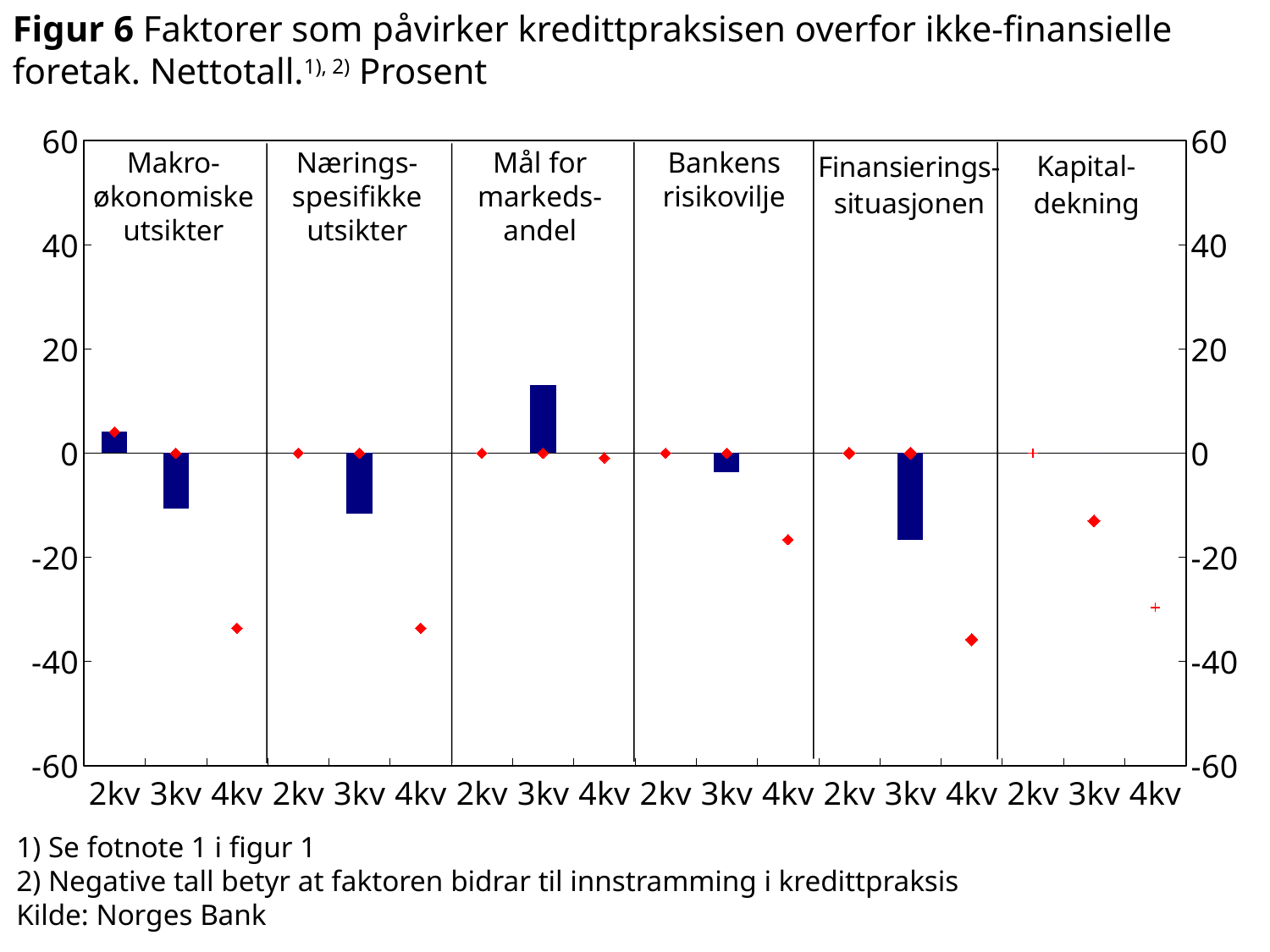
Is the 4kv value for Makroøkonomiske utsikter greater or less than -20? less Is the 3kv bar for Finansieringssituasjonen greater or less than -20? greater How many factor panels are shown in the chart? 6 Which factor has the lowest bar for 3kv? Finansieringssituasjonen What kind of chart is shown in Figur 6? combination bar and line chart (bars with diamond point markers) Do the values for Makroøkonomiske utsikter rise or fall from 2kv to 4kv? fall What is the source of the chart? Norges Bank Which is larger, the 3kv bar for Makroøkonomiske utsikter or the 3kv bar for Mål for markedsandel? Mål for markedsandel Which factor has the highest bar for 3kv? Mål for markedsandel According to footnote 2, what do negative numbers mean? The factor contributes to tightening of credit practice (innstramming i kredittpraksis) How many quarters are shown on the x axis within each factor panel? 3 Is the 3kv bar for Mål for markedsandel greater or less than 20? less